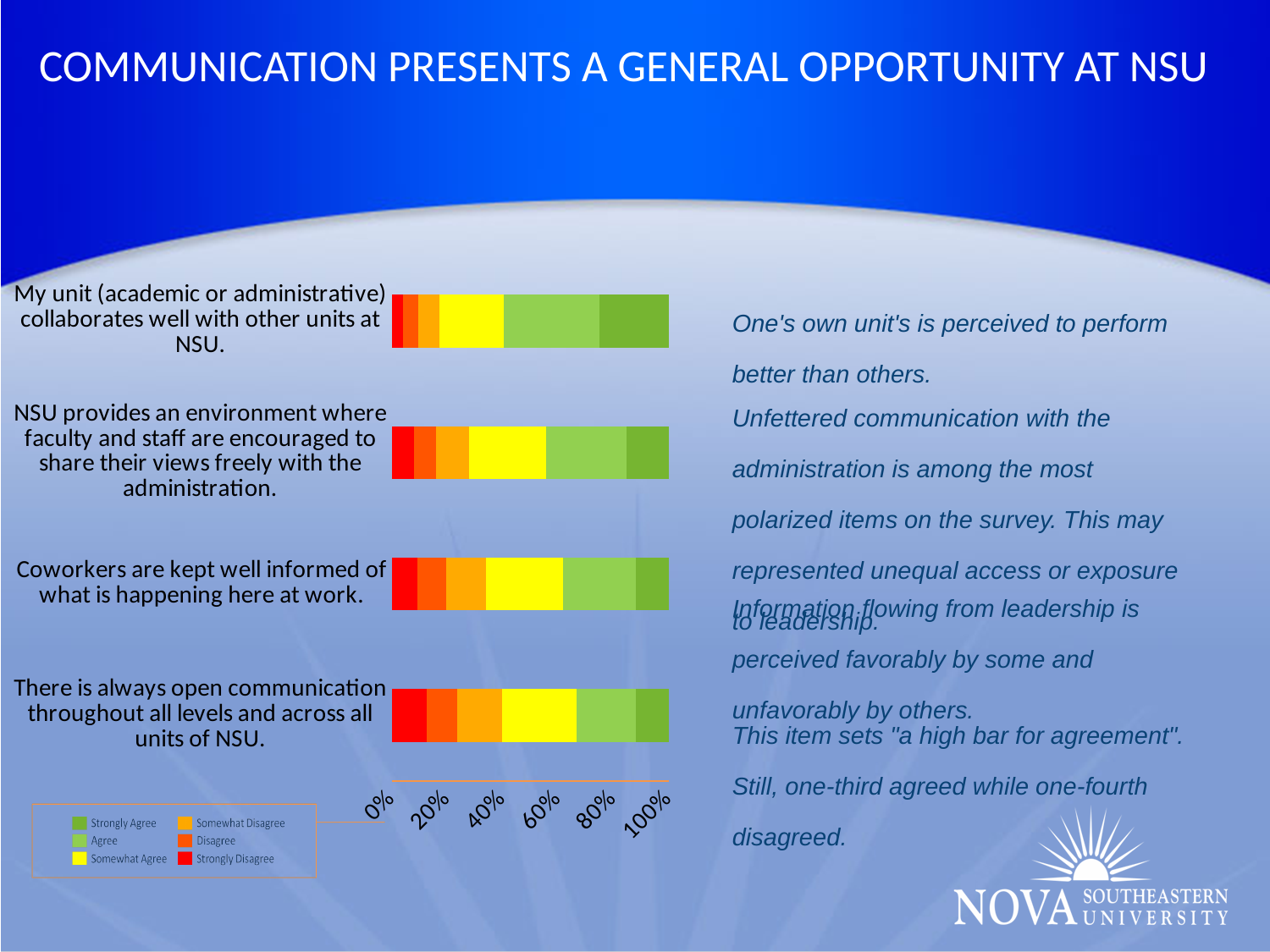
Is the 'Agree' segment for 'My unit (academic or administrative) collaborates well with other units at NSU.' greater or less than 20%? greater What is the highest value shown on the percentage axis of the chart? 100% What kind of chart is shown on the slide? stacked bar chart How many response categories does the chart legend list? 6 Is the 'Strongly Agree' segment for 'There is always open communication throughout all levels and across all units of NSU.' greater or less than 20%? less Which survey item has the largest 'Strongly Agree' segment? My unit (academic or administrative) collaborates well with other units at NSU. Is the 'Somewhat Agree' segment for 'My unit (academic or administrative) collaborates well with other units at NSU.' greater or less than 40%? less Which colour represents 'Strongly Agree' in the chart legend? dark green Is the 'Strongly Agree' segment larger for 'My unit (academic or administrative) collaborates well with other units at NSU.' or for 'There is always open communication throughout all levels and across all units of NSU.'? My unit (academic or administrative) collaborates well with other units at NSU. Is the 'Strongly Disagree' segment larger for 'There is always open communication throughout all levels and across all units of NSU.' or for 'My unit (academic or administrative) collaborates well with other units at NSU.'? There is always open communication throughout all levels and across all units of NSU. How many survey items (categories) are plotted in the chart? 4